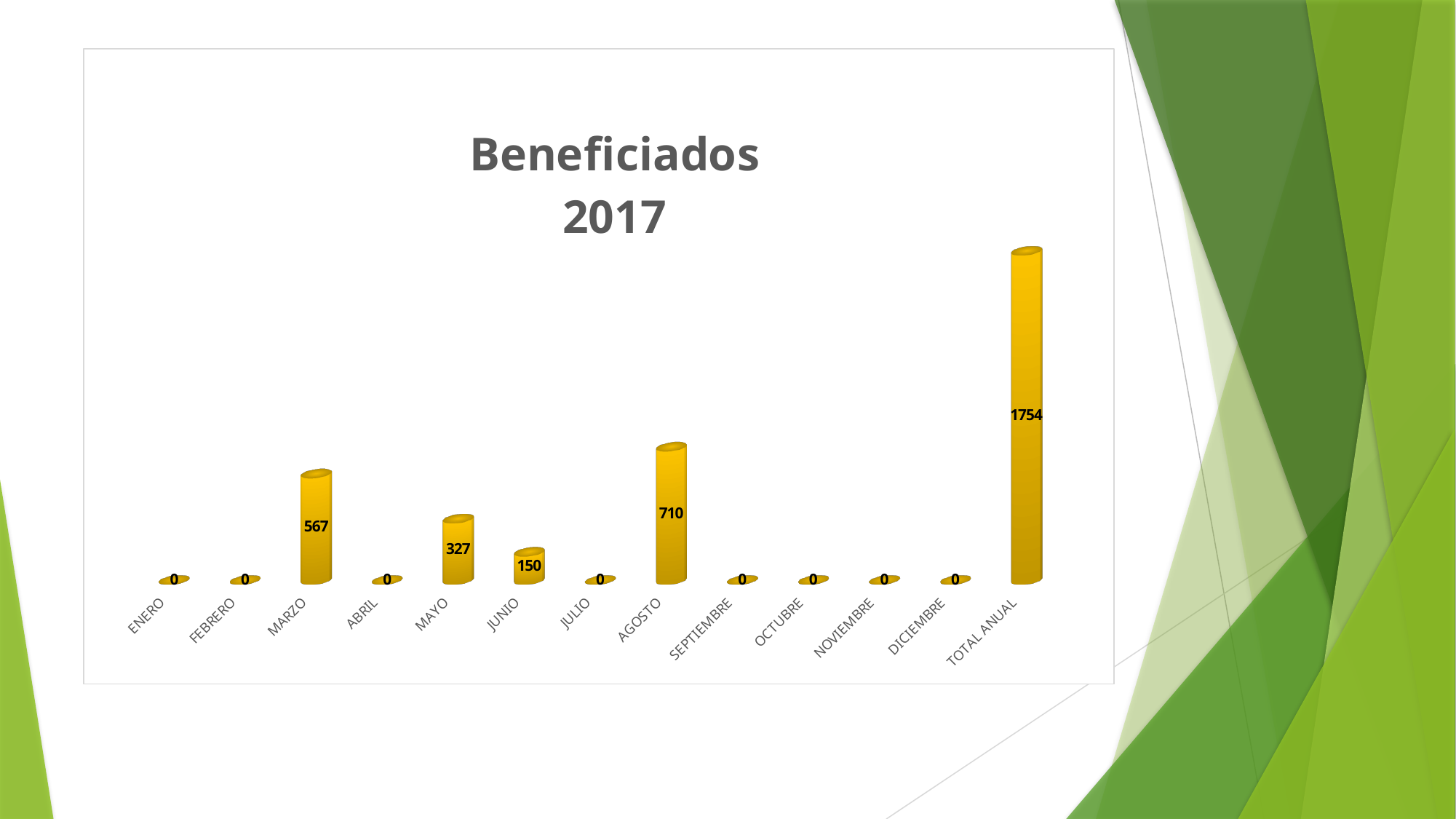
What is the value for MAYO? 327 What is the value for TOTAL ANUAL? 1754 What kind of chart is this? bar chart What is the value for AGOSTO? 710 What is the difference between the values for AGOSTO and MARZO? 143 Which is larger, the value for MARZO or the value for MAYO? MARZO What is the difference between the values for MAYO and JUNIO? 177 What is the value for MARZO? 567 What is the value for JUNIO? 150 How many categories are shown on the x axis? 13 What is the title of the chart? Beneficiados 2017 Which month has the highest value? AGOSTO